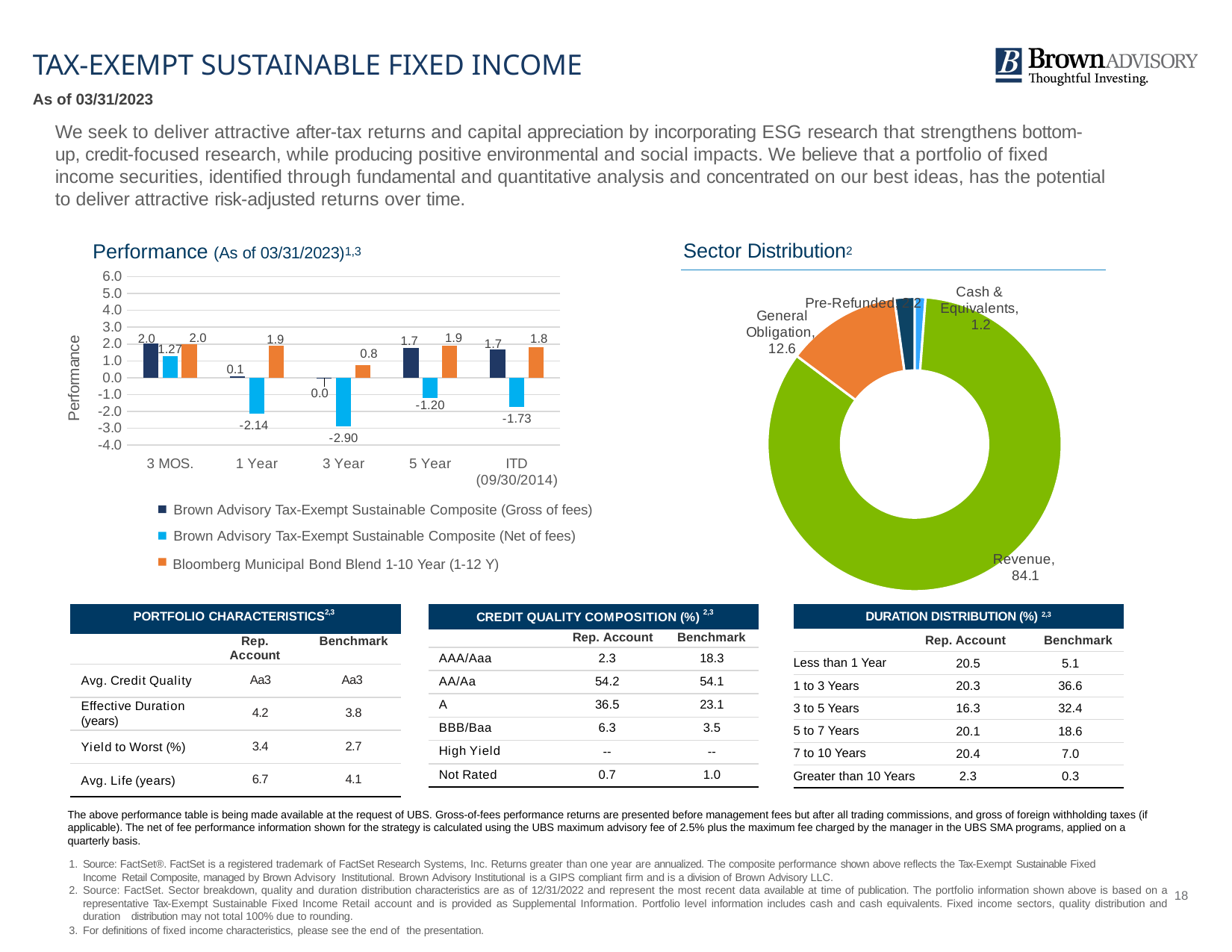
In the Performance chart, which is larger for 1 Year: the Gross of fees composite or the Bloomberg Municipal Bond Blend 1-10 Year (1-12 Y)? Bloomberg Municipal Bond Blend 1-10 Year (1-12 Y) In the Performance chart, what is the value for the Brown Advisory Tax-Exempt Sustainable Composite (Net of fees) for 3 Year? -2.90 In the Sector Distribution chart, which sector has the smallest share? Cash & Equivalents What kind of chart is the Performance chart? Bar chart In the Performance chart, what is the value for the Bloomberg Municipal Bond Blend 1-10 Year (1-12 Y) for 1 Year? 1.9 How many series does the legend of the Performance chart list? 3 How many periods are shown on the x axis of the Performance chart? 5 In the Performance chart, what is the difference between the Bloomberg Municipal Bond Blend 1-10 Year (1-12 Y) and the Brown Advisory Tax-Exempt Sustainable Composite (Net of fees) for 5 Year? 3.1 In the Sector Distribution chart, what is the value for Revenue? 84.1 In the Performance chart, what is the value for the Brown Advisory Tax-Exempt Sustainable Composite (Gross of fees) for 5 Year? 1.7 In the Sector Distribution chart, what is the difference between General Obligation and Pre-Refunded? 10.4 In the Performance chart, which period has the lowest value for the Brown Advisory Tax-Exempt Sustainable Composite (Net of fees)? 3 Year